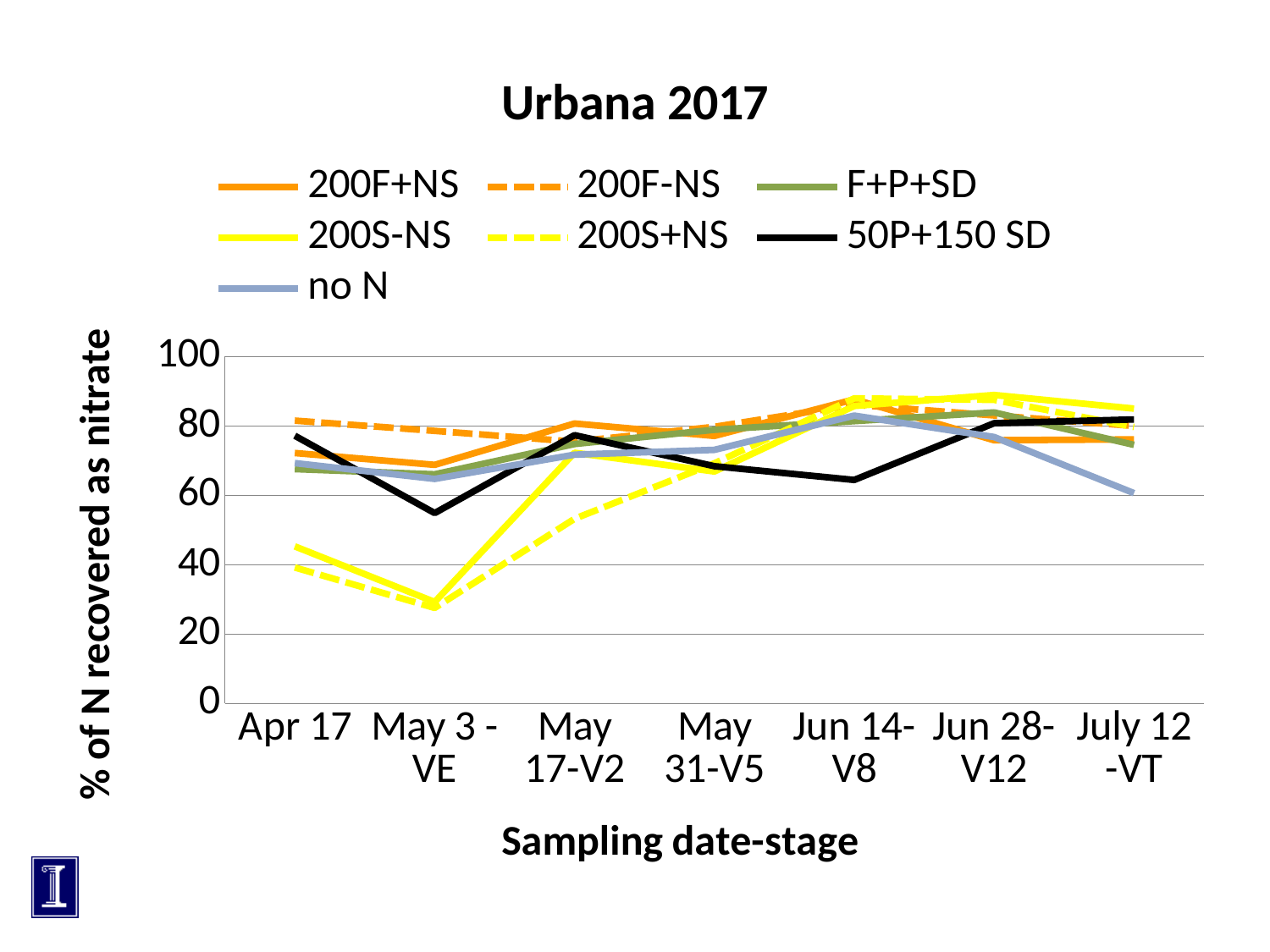
At Apr 17, which is larger: 200F-NS or 200S-NS? 200F-NS Does the value for no N rise or fall from Jun 14-V8 to July 12 -VT? fall Is the value for 200S-NS at May 3 - VE greater or less than 40? less How many sampling date-stage categories are shown on the x axis? 7 Is the value for 200S+NS at Apr 17 greater or less than 60? less How many series does the legend list? 7 What is the title of the chart? Urbana 2017 Is the value for no N at July 12 -VT greater or less than 80? less What kind of chart is shown on the slide? line chart What is the label of the y axis? % of N recovered as nitrate At May 3 - VE, which is larger: 50P+150 SD or 200S-NS? 50P+150 SD